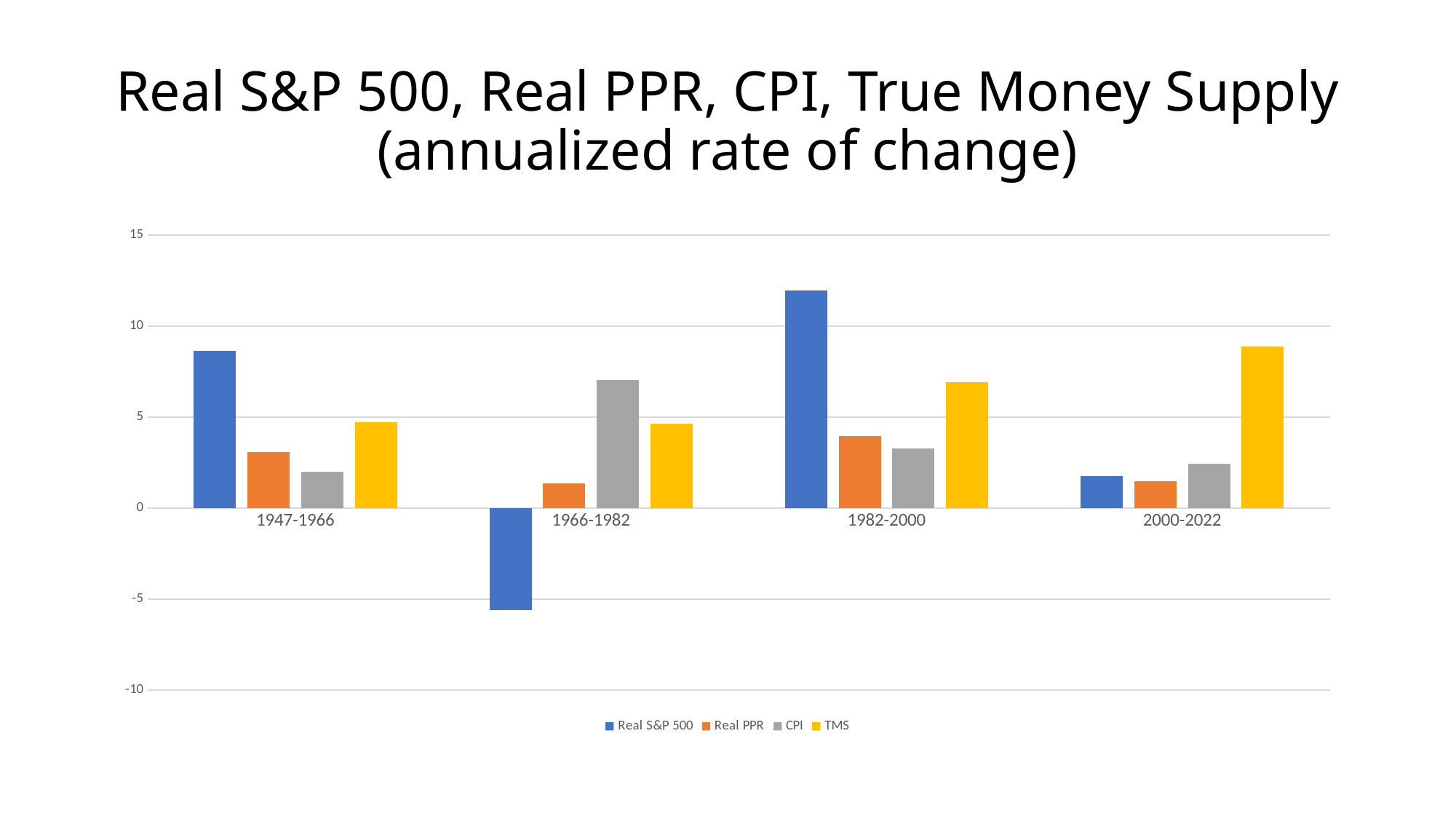
How many time periods are shown on the x axis of the chart? 4 In the 1966-1982 period, which is larger: CPI or TMS? CPI In which period is the TMS value the highest? 2000-2022 How many series does the chart's legend list? 4 Is the Real S&P 500 value for 1982-2000 greater or less than 10? greater In which period is the Real S&P 500 annualized rate of change the lowest? 1966-1982 What colour represents the TMS series in the chart? Yellow What kind of chart is shown on the slide? Bar chart In the 2000-2022 period, which is larger: TMS or Real S&P 500? TMS Is the Real S&P 500 value for 1966-1982 greater or less than 0? less In which period is the Real S&P 500 annualized rate of change the highest? 1982-2000 Is the CPI value for 1966-1982 greater or less than 5? greater